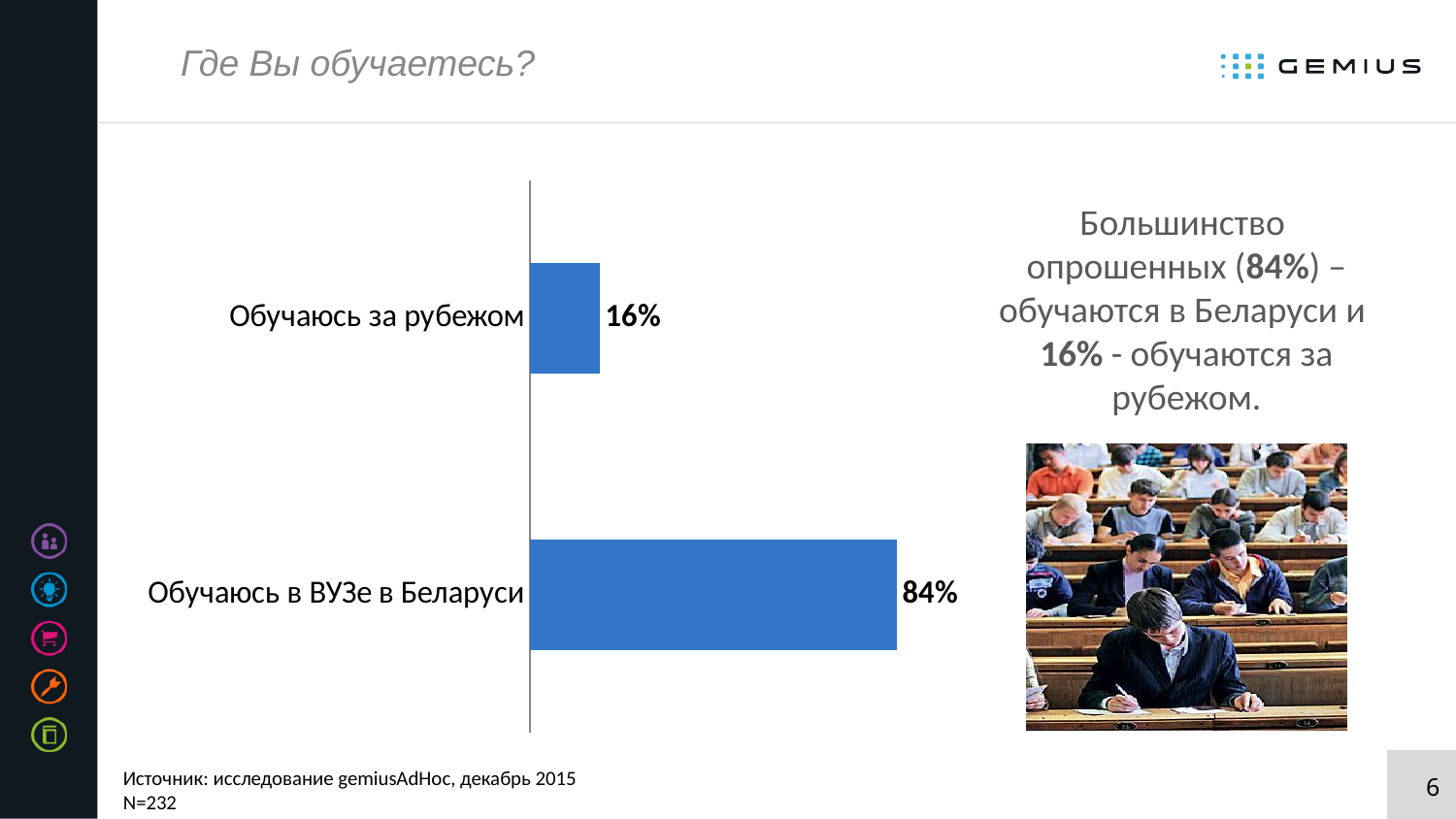
How many categories are shown in the chart? 2 What kind of chart is shown on the slide? Bar chart What is the difference between the values for "Обучаюсь в ВУЗе в Беларуси" and "Обучаюсь за рубежом"? 68% Which category has the lowest value? Обучаюсь за рубежом What is the total of the two values shown in the chart? 100% What is the value for "Обучаюсь в ВУЗе в Беларуси"? 84% Which is larger: the value for "Обучаюсь за рубежом" or the value for "Обучаюсь в ВУЗе в Беларуси"? Обучаюсь в ВУЗе в Беларуси What is the title of the slide containing the chart? Где Вы обучаетесь? What colour are the bars in the chart? Blue What is the value for "Обучаюсь за рубежом"? 16% Which category has the highest value? Обучаюсь в ВУЗе в Беларуси